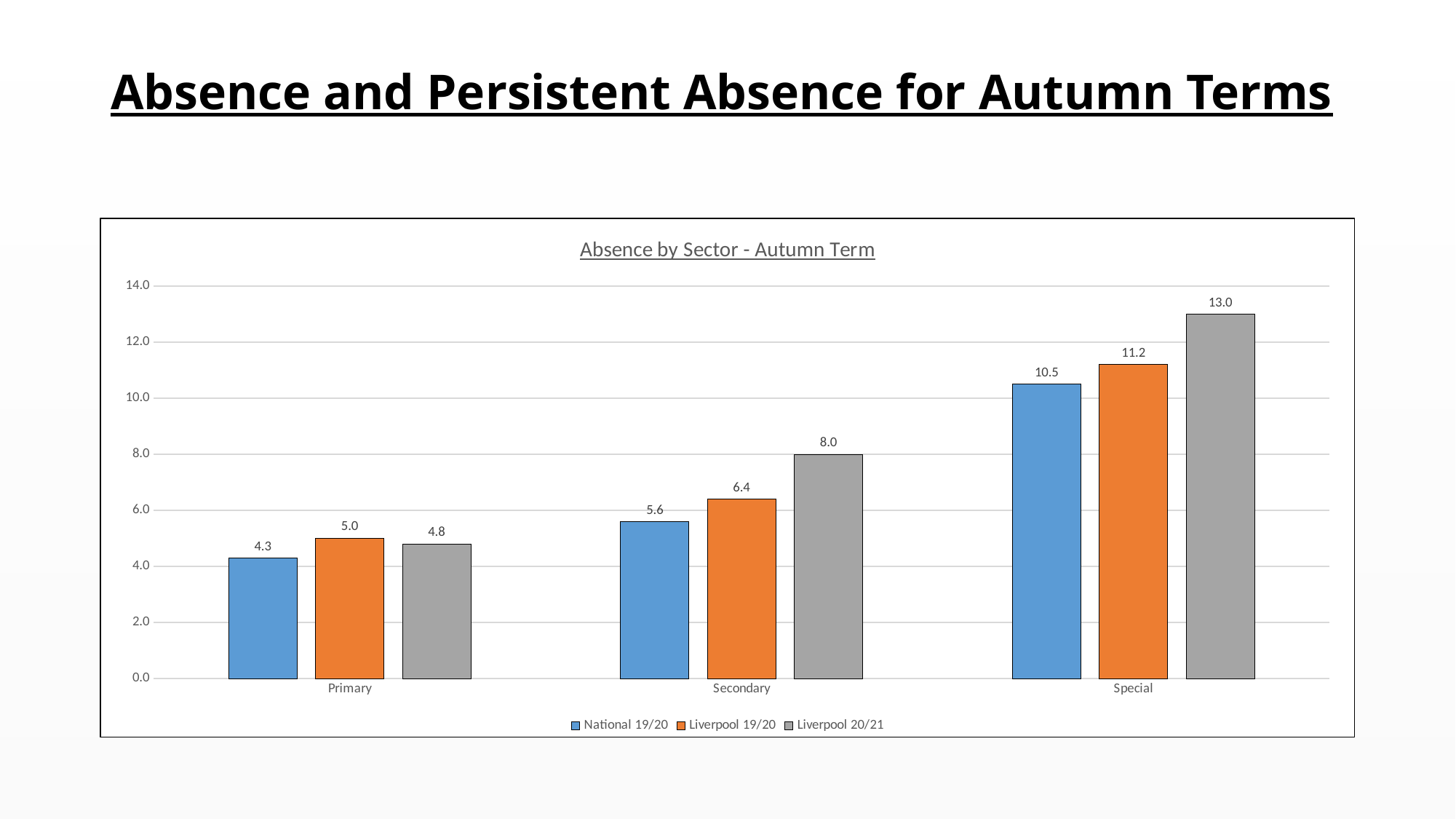
What kind of chart is shown on the slide? Bar chart What is the value for Liverpool 20/21 in the Special sector? 13.0 Which sector has the lowest National 19/20 value? Primary What is the value for National 19/20 in the Primary sector? 4.3 Is the Liverpool 20/21 value for Secondary greater or less than 6.0? greater Which is larger in the Primary sector: Liverpool 19/20 or Liverpool 20/21? Liverpool 19/20 What is the difference between the Liverpool 20/21 and National 19/20 values for the Special sector? 2.5 Which sector has the highest Liverpool 20/21 value? Special How many series does the legend list? 3 What is the title of the chart? Absence by Sector - Autumn Term What is the value for Liverpool 19/20 in the Secondary sector? 6.4 How many sectors are shown on the x axis? 3